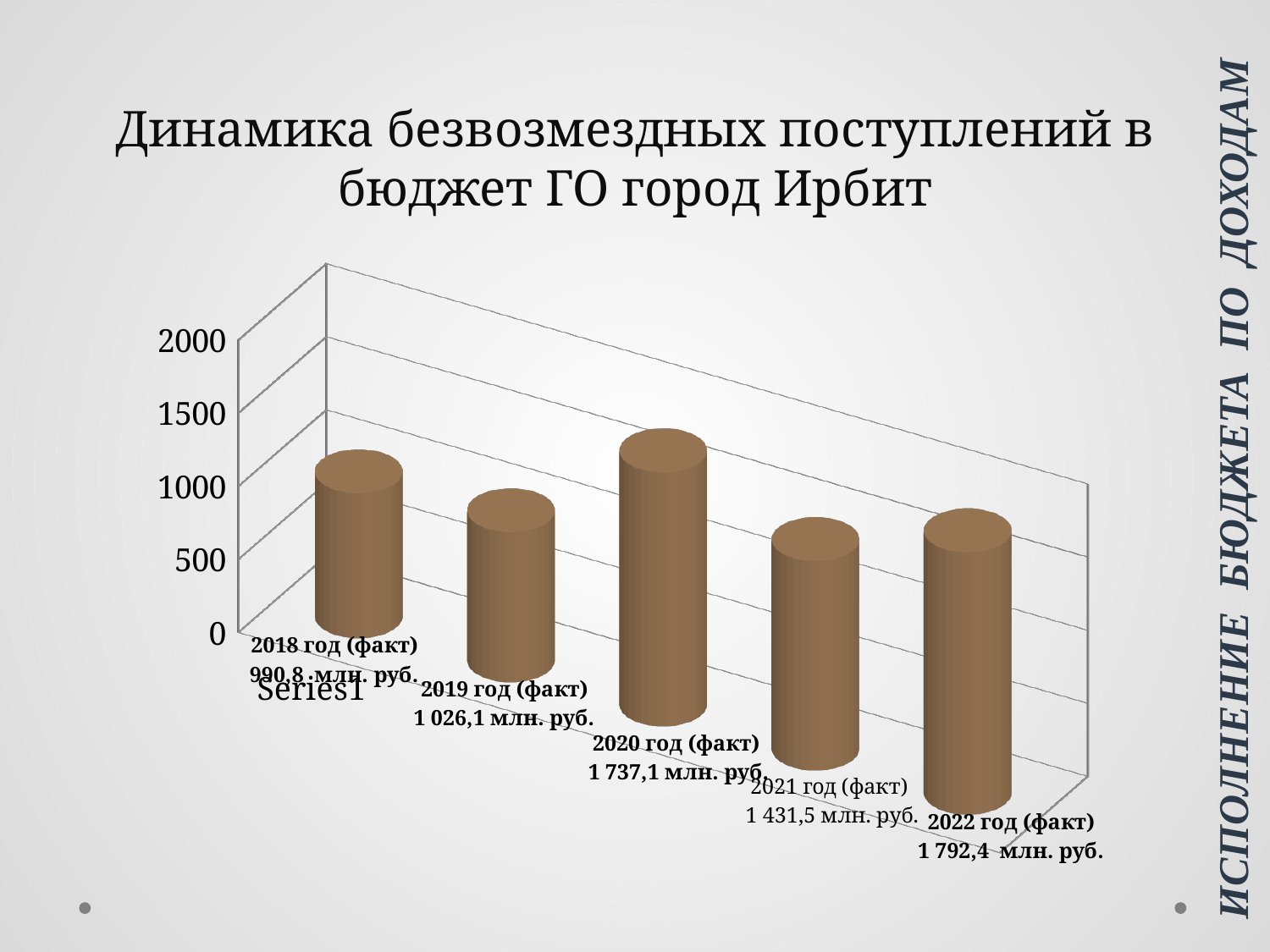
Is the value for 2019 год (факт) greater or less than 1500? less What is the value for 2022 год (факт)? 1 792,4 млн. руб. What is the value for 2018 год (факт)? 990,8 млн. руб. What is the difference between the values for 2022 год (факт) and 2021 год (факт)? 360,9 млн. руб. What is the difference between the values for 2020 год (факт) and 2019 год (факт)? 711,0 млн. руб. What is the title of the chart? Динамика безвозмездных поступлений в бюджет ГО город Ирбит What is the value for 2020 год (факт)? 1 737,1 млн. руб. What kind of chart is shown on the slide? bar chart Which year has the highest value? 2022 год (факт) How many years are shown in the chart? 5 Which year has the lowest value? 2018 год (факт) Which is larger, the value for 2020 год (факт) or 2021 год (факт)? 2020 год (факт)